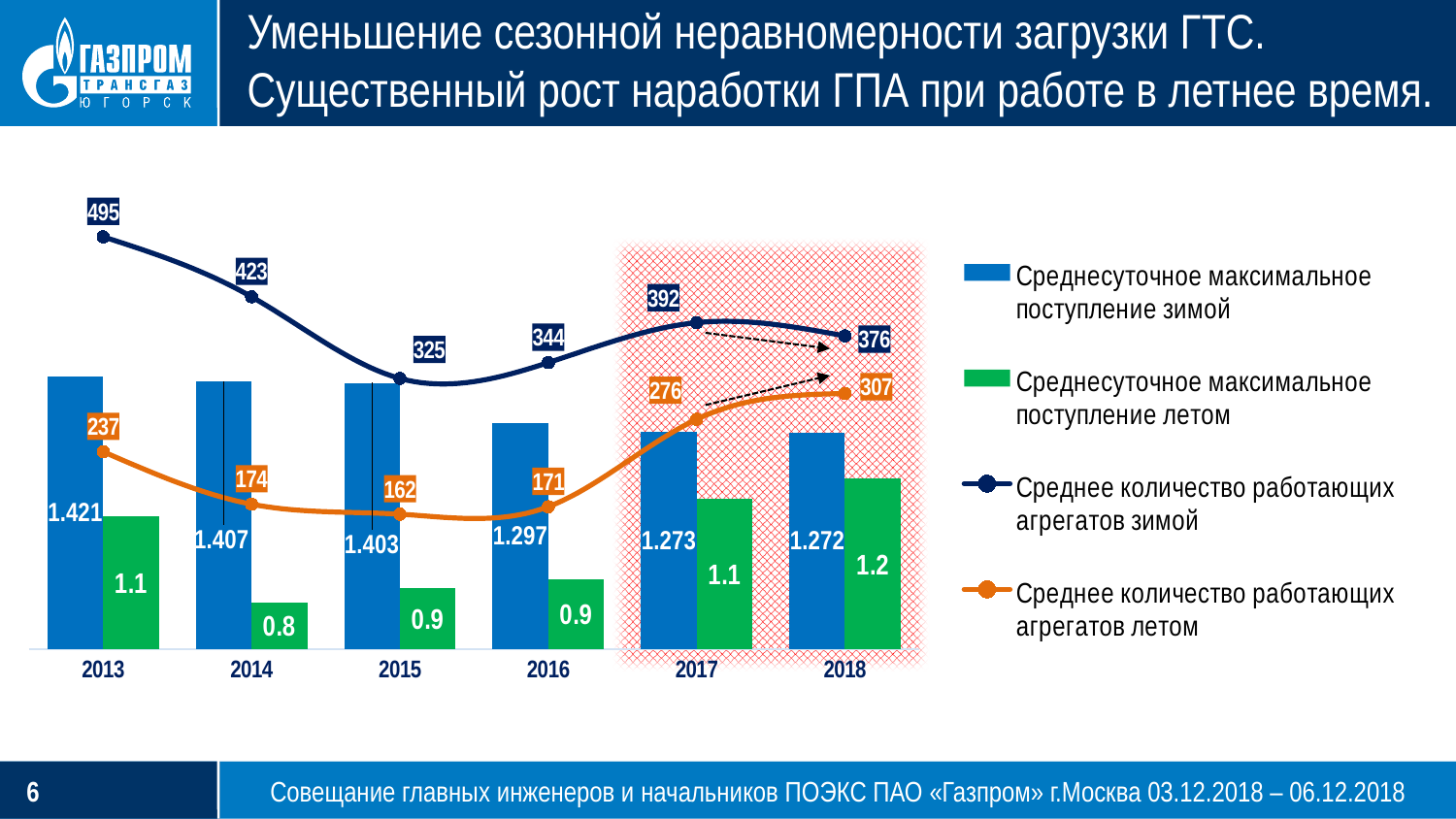
What is the difference between the dark blue line value for 2013 and for 2018? 119 Which is larger: the green bar value for 2018 or for 2013? 2018 Do the blue bar values (Среднесуточное максимальное поступление зимой) rise or fall from 2013 to 2018? Fall What is the value of the dark blue line (Среднее количество работающих агрегатов зимой) for 2015? 325 In which year is the dark blue line (Среднее количество работающих агрегатов зимой) highest? 2013 In which year is the orange line (Среднее количество работающих агрегатов летом) lowest? 2015 How many years are shown on the x axis? 6 What is the value of the orange line (Среднее количество работающих агрегатов летом) for 2018? 307 What is the value of the green bar (Среднесуточное максимальное поступление летом) for 2014? 0.8 What is the value of the blue bar (Среднесуточное максимальное поступление зимой) for 2013? 1.421 What kind of chart is shown on the slide? Combined bar and line chart How many series does the legend list? 4